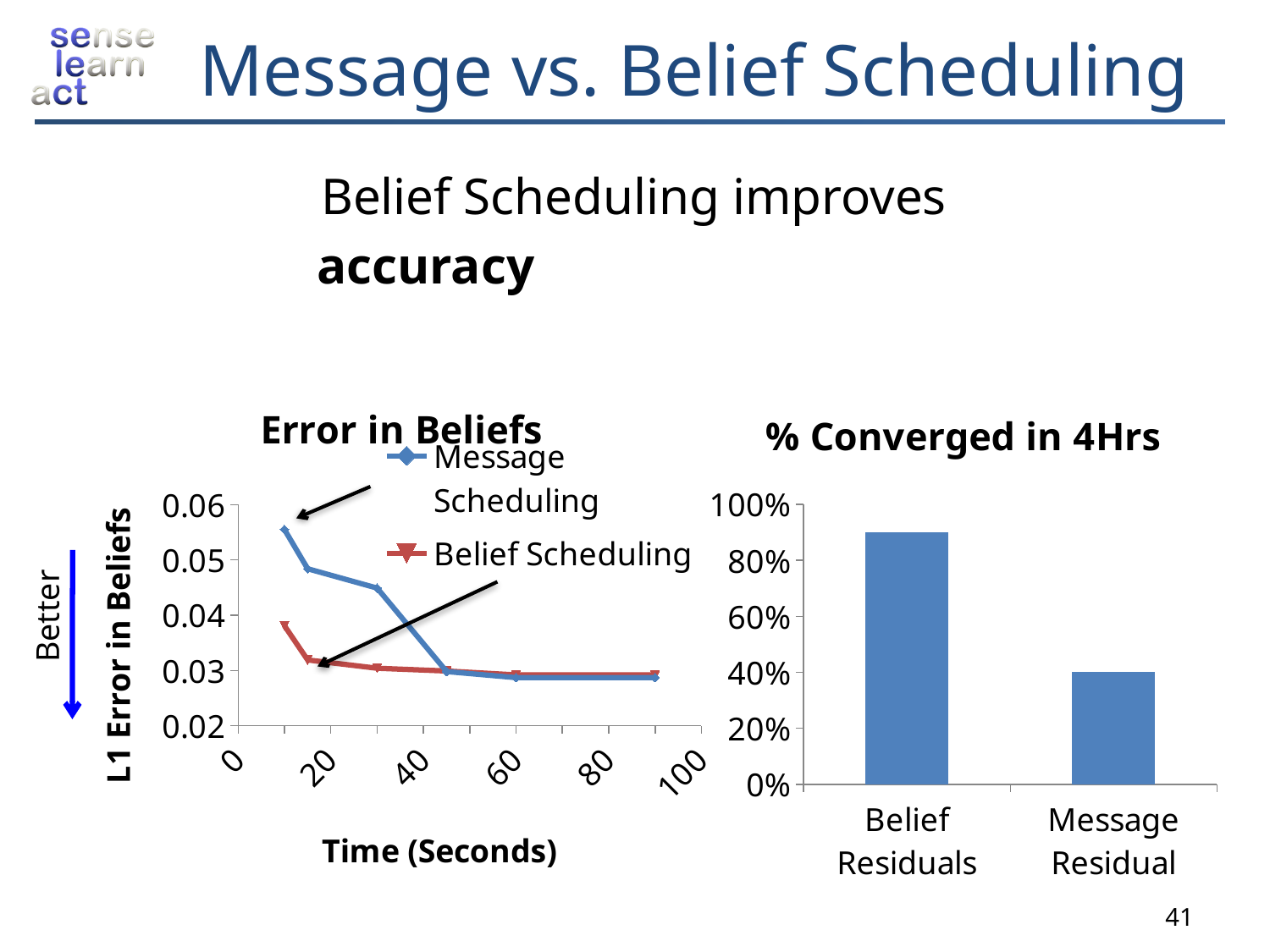
In the "Error in Beliefs" chart, how many series does the legend list? 2 In the "Error in Beliefs" chart, what is the label of the x axis? Time (Seconds) In the "% Converged in 4Hrs" chart, how many categories are shown? 2 In the "% Converged in 4Hrs" chart, is the value for Message Residual greater or less than 60%? less In the "% Converged in 4Hrs" chart, which category has the lowest value? Message Residual In the "Error in Beliefs" chart, what are the two series named in the legend? Message Scheduling and Belief Scheduling What kind of chart is the "Error in Beliefs" chart? line chart What kind of chart is the "% Converged in 4Hrs" chart? bar chart In the "Error in Beliefs" chart, which series has the higher L1 error at the earliest time point? Message Scheduling In the "Error in Beliefs" chart, does the Message Scheduling line rise or fall as time increases? fall In the "% Converged in 4Hrs" chart, is the value for Belief Residuals greater or less than 80%? greater In the "% Converged in 4Hrs" chart, which category has the highest value? Belief Residuals